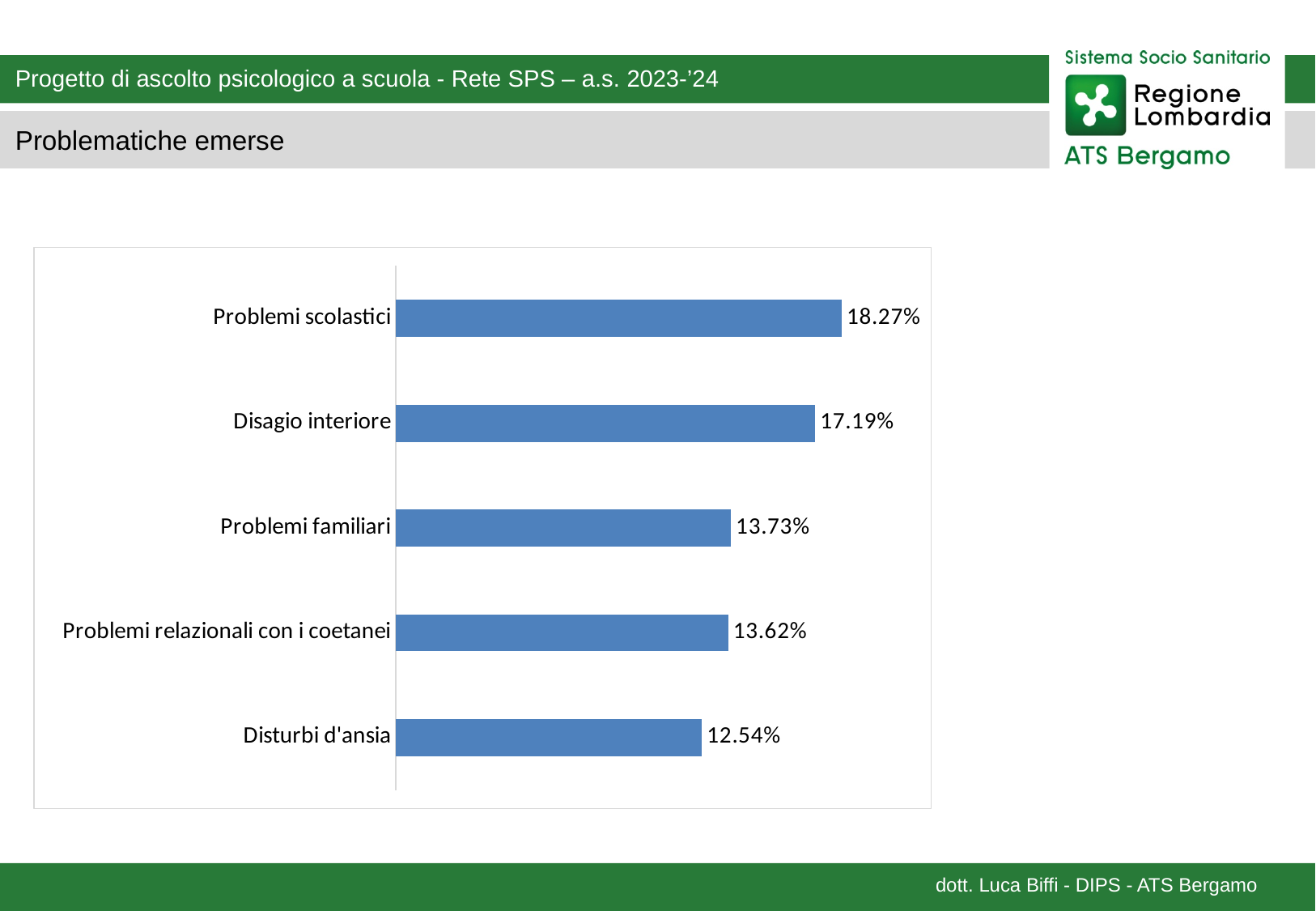
What is the value for Problemi familiari? 13.73% What is the value for Disturbi d'ansia? 12.54% What is the difference between the values for Disagio interiore and Problemi familiari? 3.46% Which is larger, the value for Disagio interiore or the value for Problemi familiari? Disagio interiore What is the difference between the values for Problemi scolastici and Disturbi d'ansia? 5.73% What is the value for Disagio interiore? 17.19% How many categories are shown in the chart? 5 Which category has the lowest value? Disturbi d'ansia What is the value for Problemi scolastici? 18.27% Which category has the highest value? Problemi scolastici What is the value for Problemi relazionali con i coetanei? 13.62% What kind of chart is shown on the slide? Bar chart